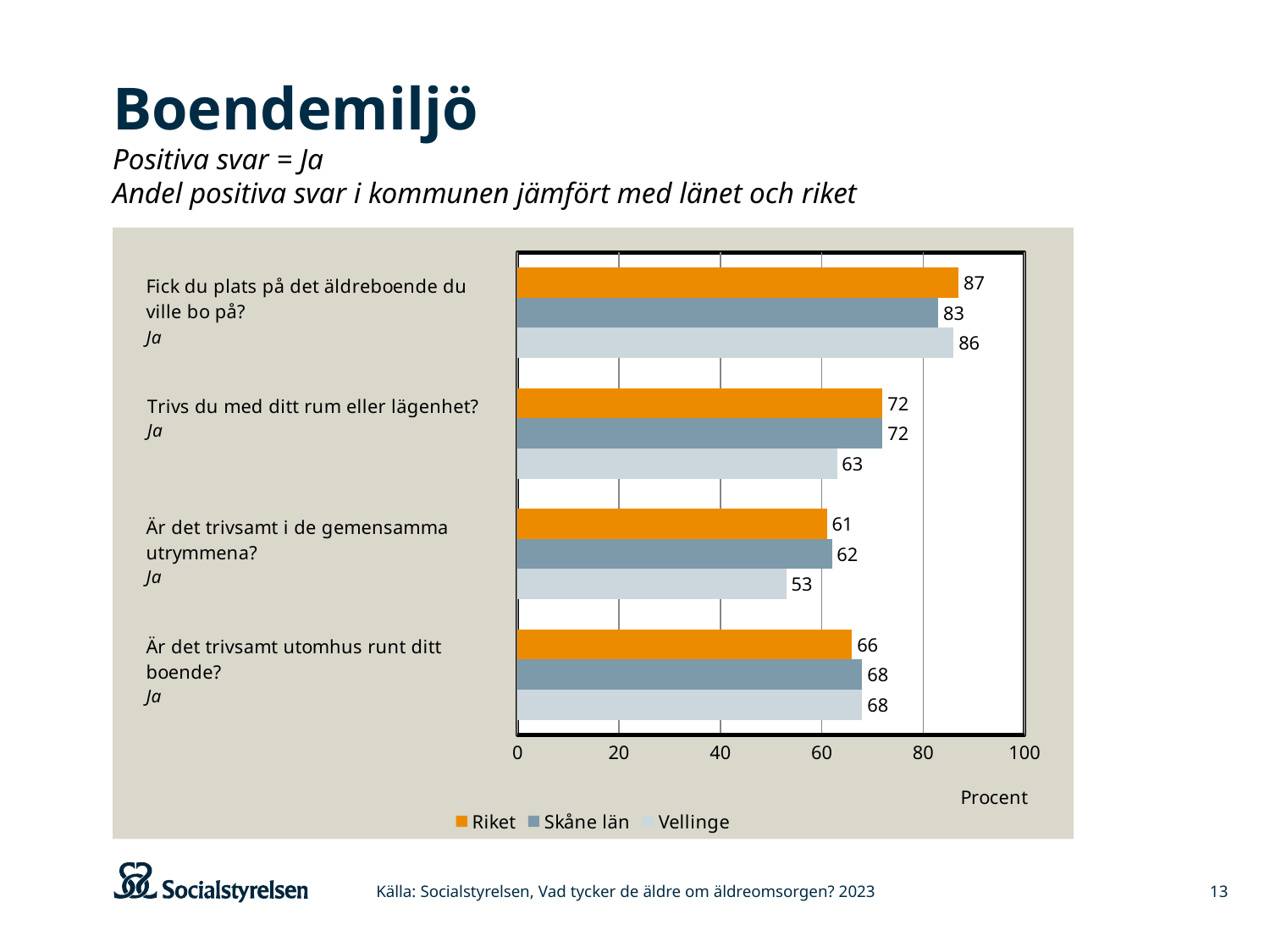
What is the value for Vellinge on "Trivs du med ditt rum eller lägenhet?"? 63 What is the value for Skåne län on "Är det trivsamt i de gemensamma utrymmena?"? 62 How many series does the legend list? 3 What is the difference between Riket and Vellinge on "Är det trivsamt i de gemensamma utrymmena?"? 8 What is the value for Riket on "Fick du plats på det äldreboende du ville bo på?"? 87 Which question has the lowest value for Vellinge? Är det trivsamt i de gemensamma utrymmena? How many questions (categories) are shown on the chart? 4 What is the label on the horizontal axis of the chart? Procent Which question has the highest value for Skåne län? Fick du plats på det äldreboende du ville bo på? What kind of chart is shown on the slide? Bar chart Which is larger on "Fick du plats på det äldreboende du ville bo på?": Skåne län or Vellinge? Vellinge What is the value for Vellinge on "Är det trivsamt utomhus runt ditt boende?"? 68